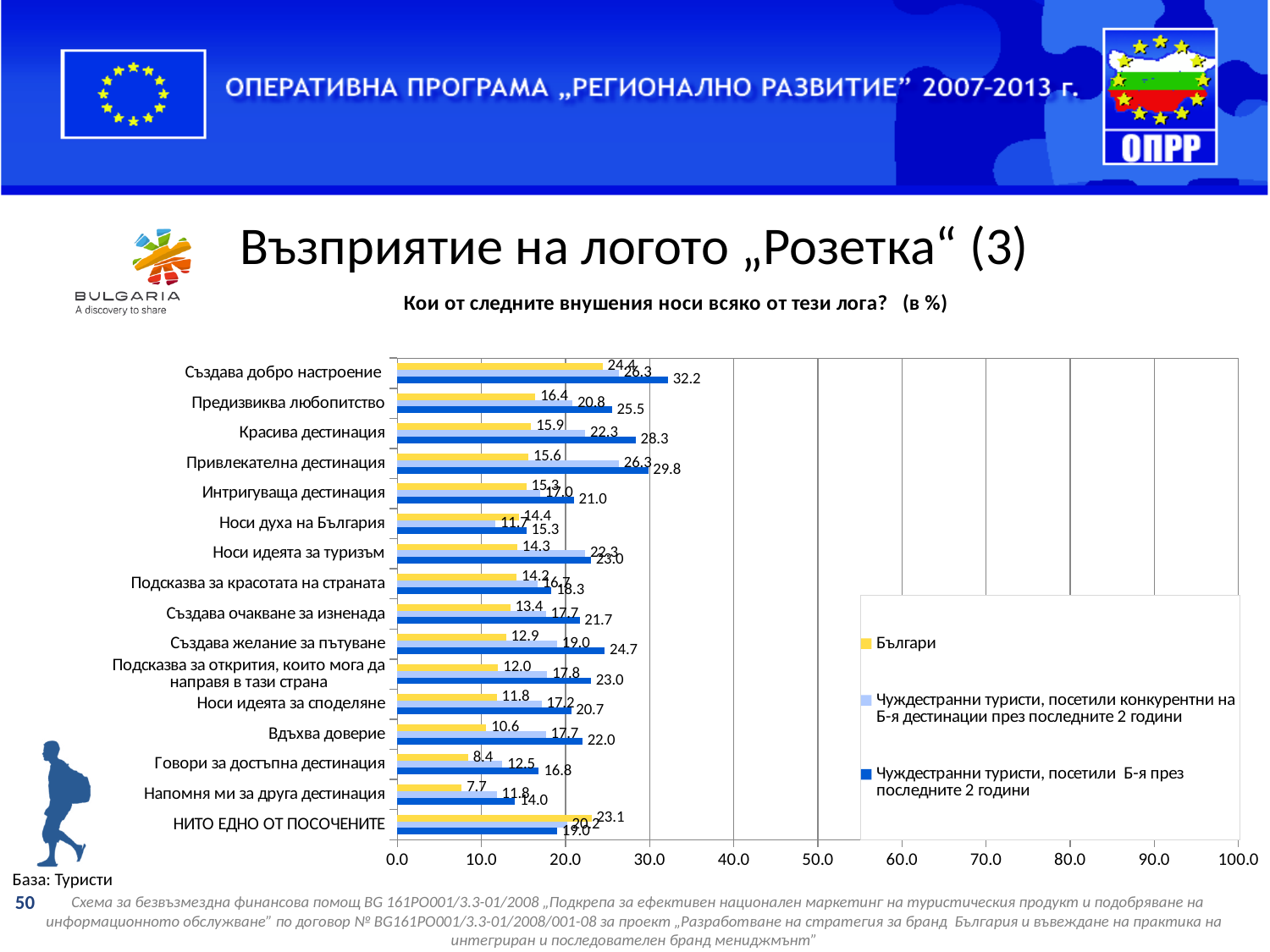
What is the value for "Българи" for "Напомня ми за друга дестинация"? 7.7 What is the value for "Чуждестранни туристи, посетили Б-я през последните 2 години" for "Създава добро настроение"? 32.2 What is the difference between the "Чуждестранни туристи, посетили Б-я през последните 2 години" value and the "Българи" value for "Създава добро настроение"? 7.8 For "Привлекателна дестинация", which is larger: the value for "Българи" or for "Чуждестранни туристи, посетили Б-я през последните 2 години"? Чуждестранни туристи, посетили Б-я през последните 2 години What kind of chart is shown on the slide? bar chart Which category has the lowest value for "Българи"? Напомня ми за друга дестинация What is the value for "Българи" for "НИТО ЕДНО ОТ ПОСОЧЕНИТЕ"? 23.1 How many series does the legend list? 3 Which category has the highest value for "Чуждестранни туристи, посетили Б-я през последните 2 години"? Създава добро настроение What is the value for "Чуждестранни туристи, посетили Б-я през последните 2 години" for "Красива дестинация"? 28.3 Is the value for "Чуждестранни туристи, посетили Б-я през последните 2 години" for "Създава добро настроение" greater or less than 30.0? greater How many categories are shown on the chart? 16